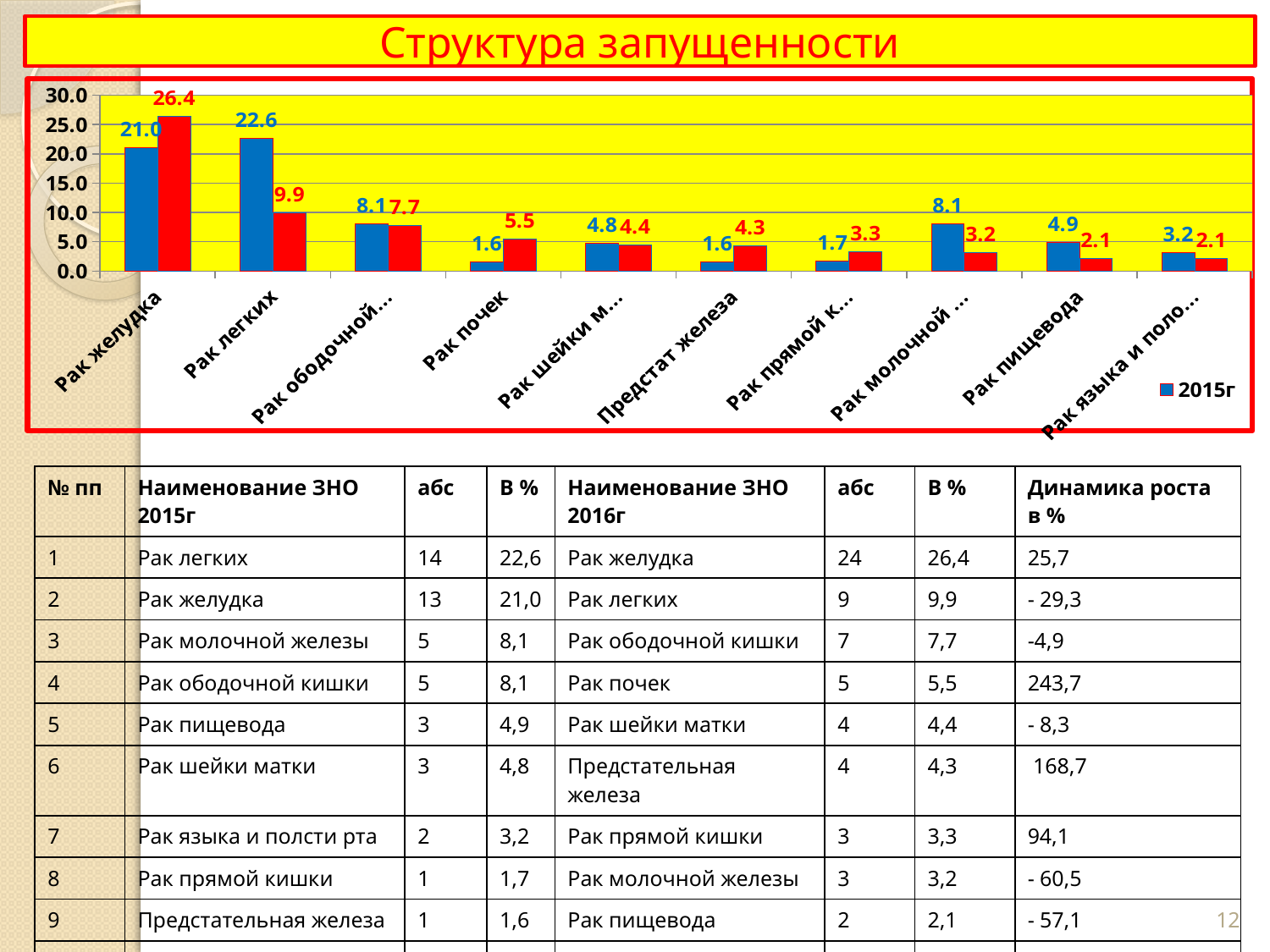
For Рак почек, which bar is larger in the chart: the blue 2015г bar or the red bar? the red bar In the chart, what is the difference between the red bar and the 2015г bar for Рак желудка? 5.4 What is the value of the red bar for Рак желудка in the chart? 26.4 Which category has the highest 2015г (blue) value in the chart? Рак легких Do the red bar values rise or fall from left to right across the chart? fall What is the 2015г value for Рак легких in the chart? 22.6 How many categories are shown on the x axis of the chart? 10 What is the title of the chart? Структура запущенности What kind of chart is shown on the slide? bar chart Which category has the highest red bar in the chart? Рак желудка What is the 2015г value for Рак пищевода in the chart? 4.9 In the chart, how much larger is the 2015г value than the red bar value for Рак легких? 12.7